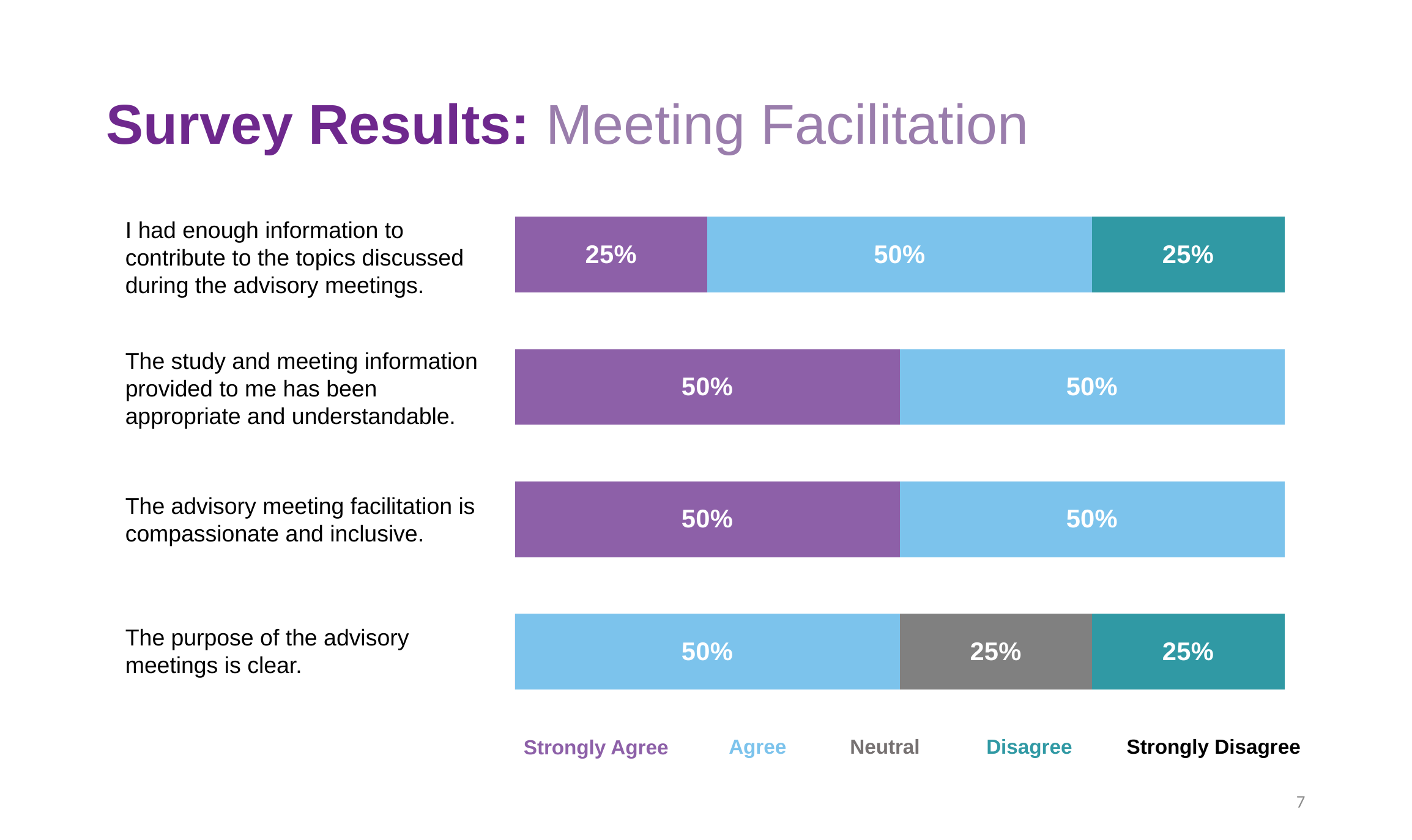
For the statement 'The purpose of the advisory meetings is clear', which is larger: the Agree share or the Neutral share? Agree How many response categories does the legend list? 5 What kind of chart is shown on the slide? Stacked bar chart What percentage of respondents disagreed that they had enough information to contribute to the topics discussed during the advisory meetings? 25% How many statements (bars) are shown in the chart? 4 What percentage of respondents strongly agreed that the study and meeting information provided has been appropriate and understandable? 50% Which colour represents 'Strongly Agree' in the chart? Purple What percentage of respondents agreed that they had enough information to contribute to the topics discussed during the advisory meetings? 50% What percentage of respondents disagreed that the purpose of the advisory meetings is clear? 25% For the statement 'I had enough information to contribute to the topics discussed during the advisory meetings', what is the difference between the Agree share and the Strongly Agree share? 25% What percentage of respondents were neutral on the statement that the purpose of the advisory meetings is clear? 25% What percentage of respondents strongly agreed that they had enough information to contribute to the topics discussed during the advisory meetings? 25%